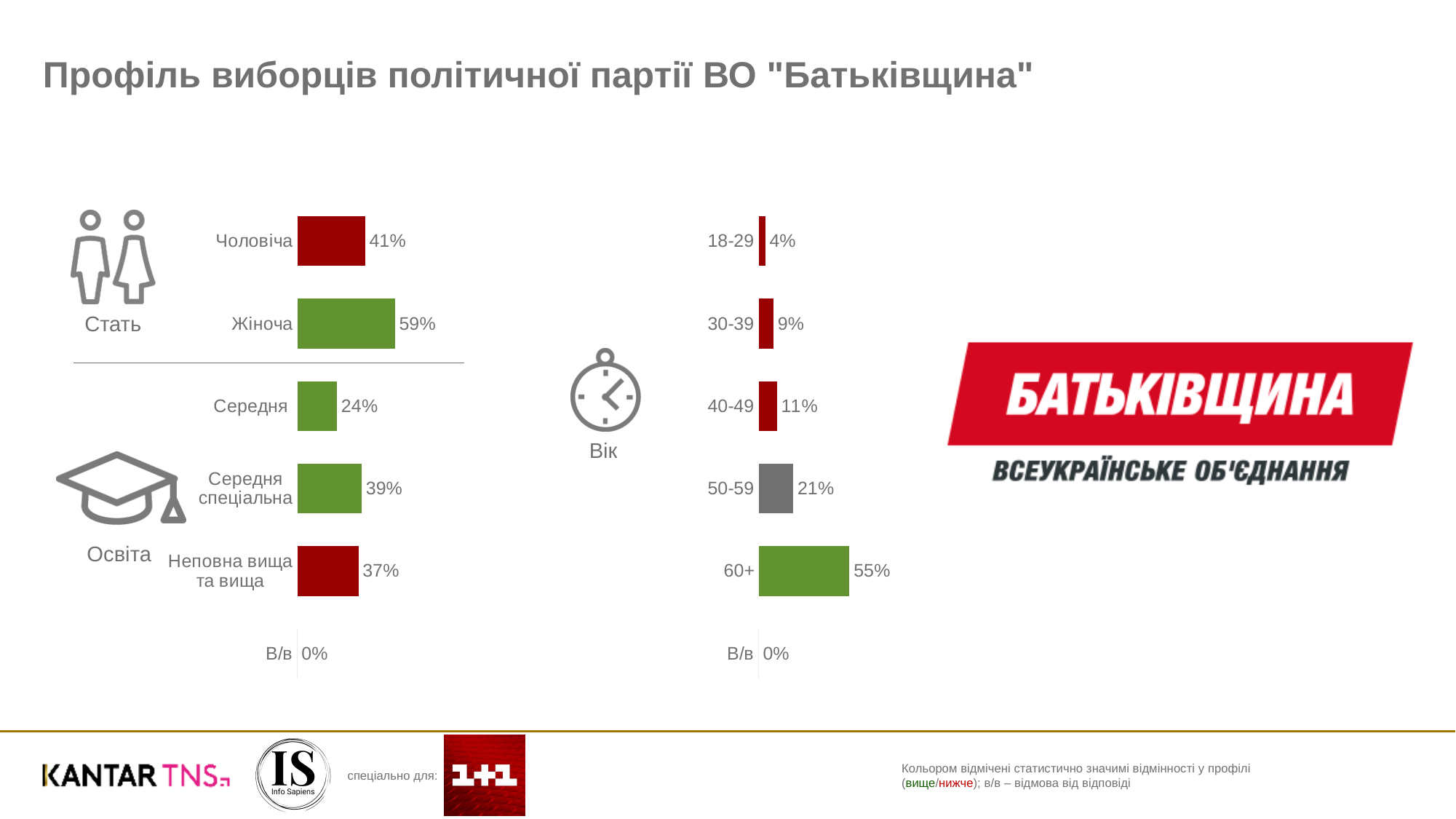
In the age chart (Вік), what is the value for the 60+ group? 55% What type of chart is used to show the age distribution (Вік)? Bar chart In the left chart, what is the value for Середня спеціальна? 39% How many age groups (excluding В/в) are shown in the age chart (Вік)? 5 In the age chart (Вік), which age group has the lowest value? 18-29 In the age chart (Вік), do the values rise or fall from the 18-29 group to the 60+ group? Rise In the age chart (Вік), what is the difference between the 50-59 and 40-49 groups? 10% In the age chart (Вік), which age group has the highest value? 60+ In the age chart (Вік), which is larger: 30-39 or 40-49? 40-49 In the left chart, what is the difference between Жіноча and Чоловіча? 18% In the left chart, which is larger: Середня спеціальна or Неповна вища та вища? Середня спеціальна In the gender and education chart on the left, what is the value for Жіноча? 59%